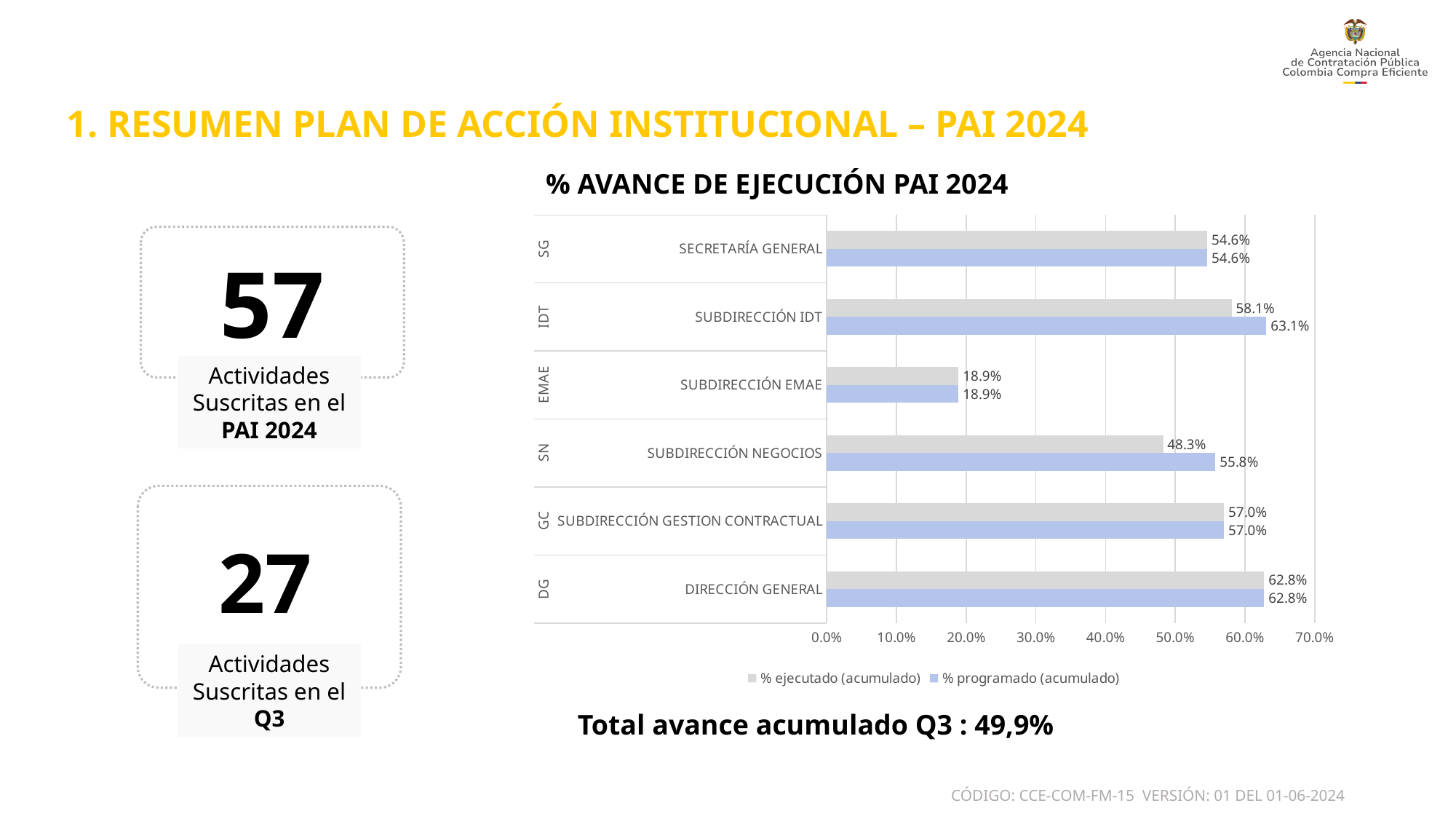
Which is larger: the % ejecutado (acumulado) value for SECRETARÍA GENERAL or for SUBDIRECCIÓN GESTION CONTRACTUAL? SUBDIRECCIÓN GESTION CONTRACTUAL Which category has the highest % programado (acumulado) value? SUBDIRECCIÓN IDT What is the difference between the % programado (acumulado) and % ejecutado (acumulado) values for SUBDIRECCIÓN NEGOCIOS? 7.5% Which category has the lowest % ejecutado (acumulado) value? SUBDIRECCIÓN EMAE What is the % programado (acumulado) value for SUBDIRECCIÓN NEGOCIOS? 55.8% How many categories are shown on the chart? 6 What kind of chart is shown on the slide? Bar chart What is the % ejecutado (acumulado) value for DIRECCIÓN GENERAL? 62.8% What is the % ejecutado (acumulado) value for SUBDIRECCIÓN IDT? 58.1% Is the % ejecutado (acumulado) value for SUBDIRECCIÓN EMAE greater or less than 20.0%? less What is the difference between the % programado (acumulado) and % ejecutado (acumulado) values for SUBDIRECCIÓN IDT? 5.0% How many series does the legend list? 2